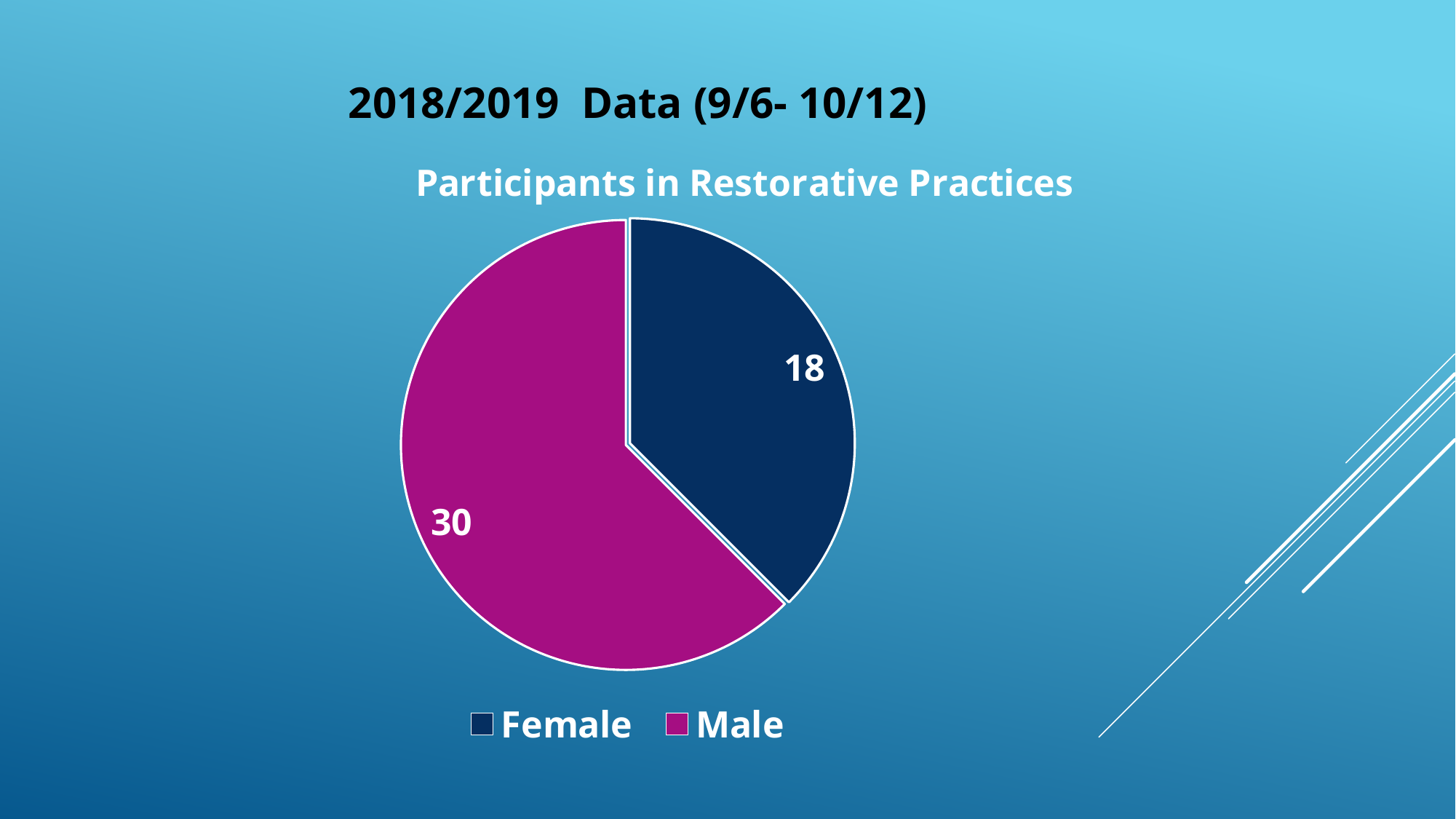
Which category has the largest slice of the pie? Male Which colour represents Female in the pie chart? Dark blue What is the total of all slices in the pie chart? 48 What share of the pie does the Male slice represent? 62.5% What is the difference between the Male and Female values? 12 Which category has the smallest slice of the pie? Female What is the value for Female in the pie chart? 18 What kind of chart is shown on the slide? Pie chart What is the value for Male in the pie chart? 30 How many categories does the pie chart show? 2 What is the title of the pie chart? Participants in Restorative Practices Which is larger, the value for Female or the value for Male? Male